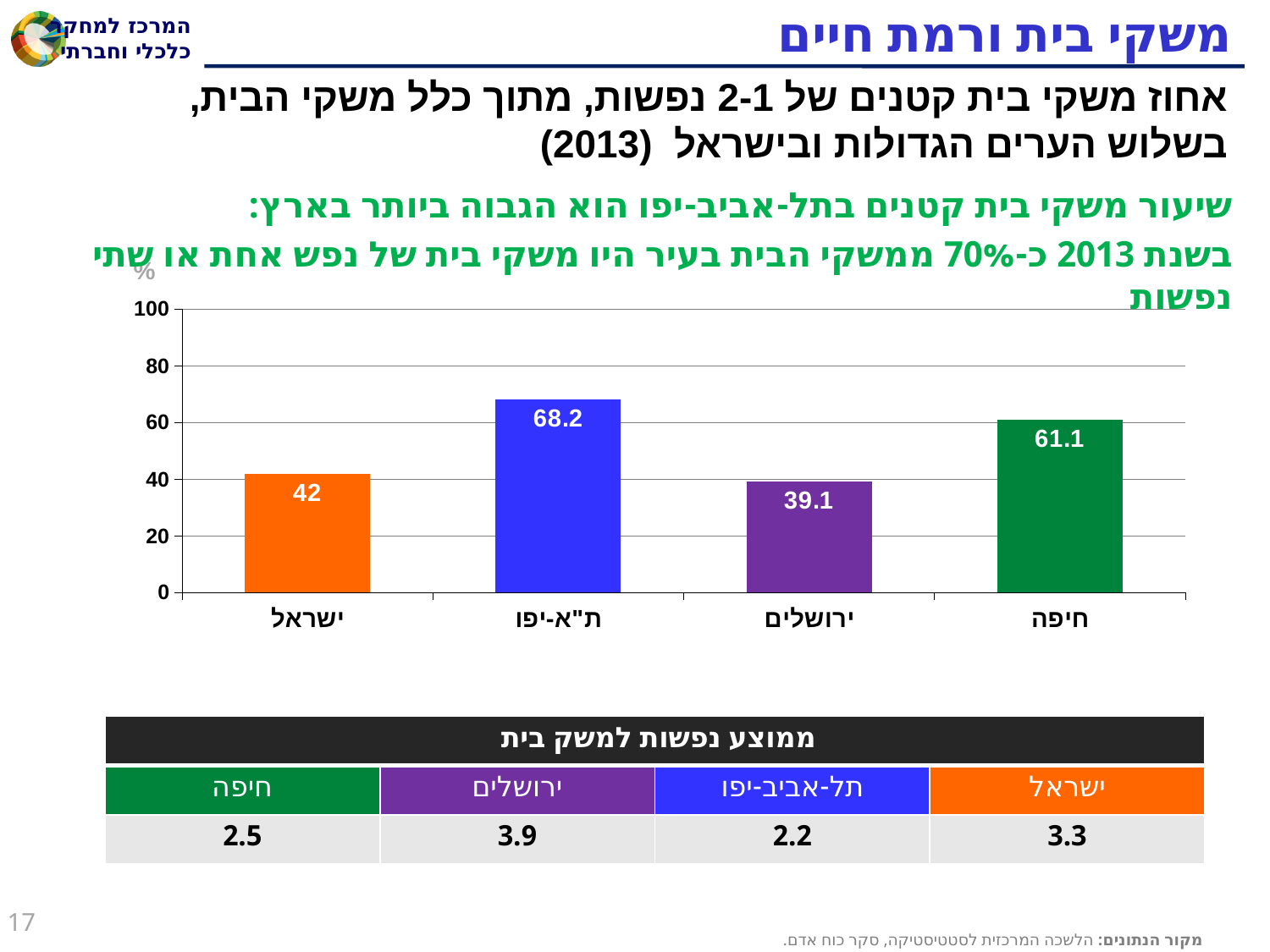
Which category has the lowest value in the bar chart? ירושלים How many categories are shown in the bar chart? 4 What is the difference between the values for חיפה and ישראל? 19.1 What is the value for ירושלים in the bar chart? 39.1 Which category has the highest value in the bar chart? ת"א-יפו What is the value for ת"א-יפו in the bar chart? 68.2 Is the value for ת"א-יפו greater or less than 60? greater What is the difference between the values for ת"א-יפו and ירושלים? 29.1 What is the value for חיפה in the bar chart? 61.1 Which is larger, the value for חיפה or the value for ישראל? חיפה What is the value for ישראל in the bar chart? 42 What kind of chart is shown on the slide? bar chart